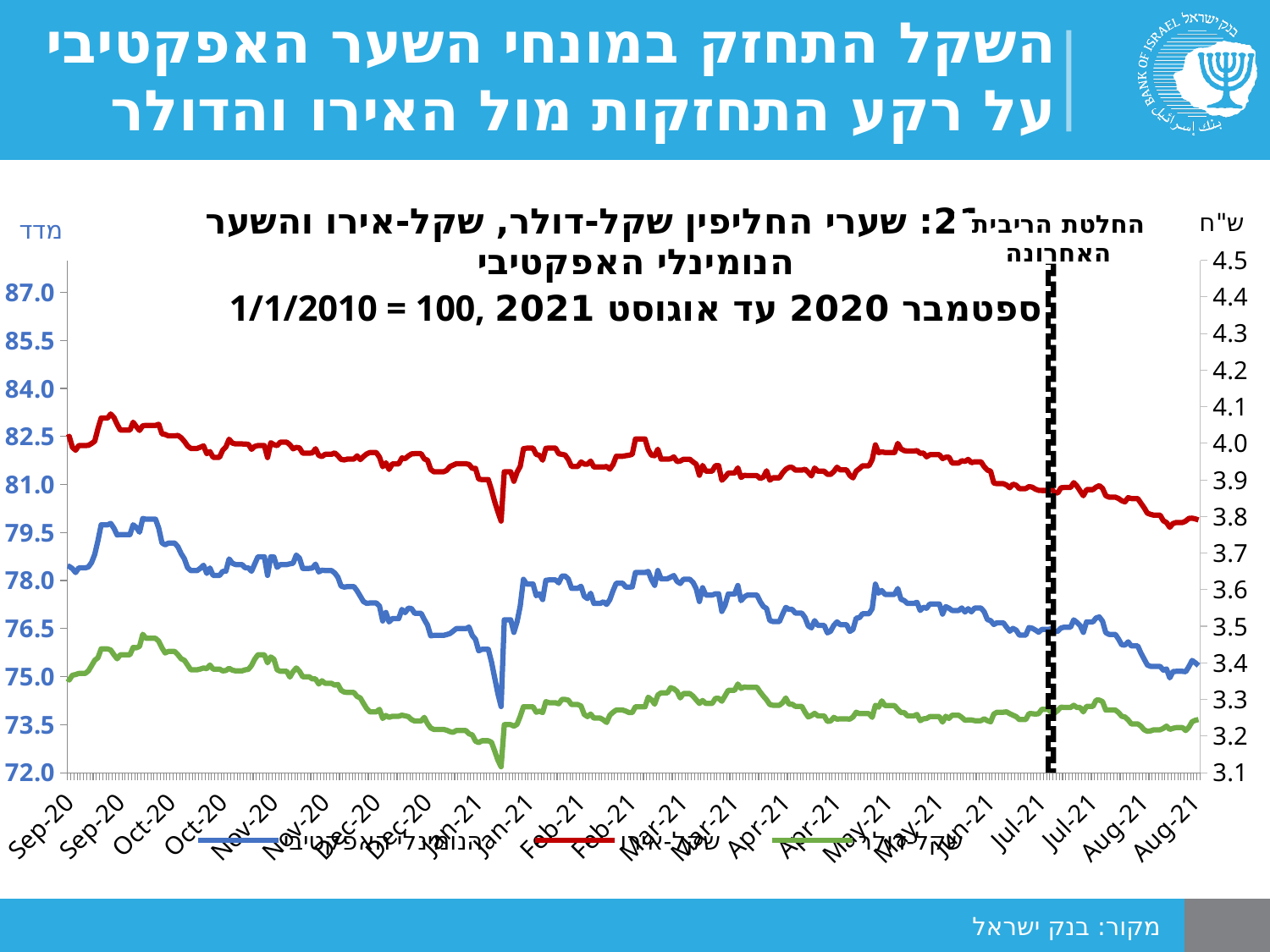
What does the vertical dashed black line near Jul-21 mark, according to its label? החלטת הריבית האחרונה What kind of chart is shown on the slide? Line chart Which line is higher on the right axis throughout the period, the red line (שקל-אירו) or the green line (שקל-דולר)? The red line (שקל-אירו) Is the value of the green line (שקל-דולר) at its peak in Oct-20 greater or less than 3.4 on the right axis? greater Is the value of the red line (שקל-אירו) at its lowest point in Jan-21 greater or less than 3.9 on the right axis? less How many series does the chart's legend list? 3 Is the value of the blue line (השער הנומינלי האפקטיבי) at Aug-21 greater or less than 76.5 on the left axis? less Does the red line (שקל-אירו) rise or fall overall from Sep-20 to Aug-21? Fall Does the blue line (השער הנומינלי האפקטיבי) rise or fall overall from Sep-20 to Aug-21? Fall Which series is plotted in red? שקל-אירו Is the blue line (השער הנומינלי האפקטיבי) higher at Sep-20 or at Aug-21? Sep-20